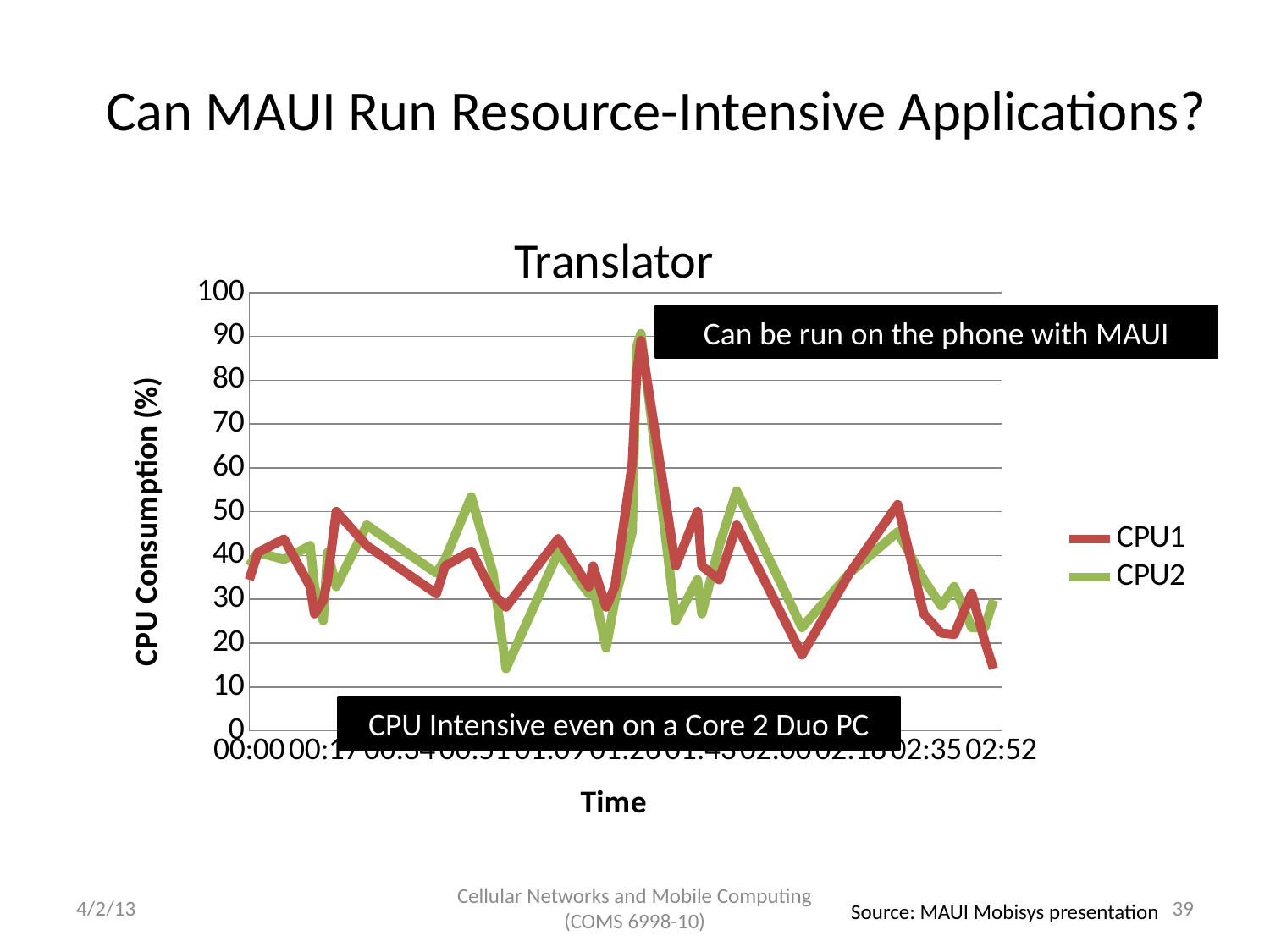
What is the title of the chart? Translator What is the label of the y axis of the Translator chart? CPU Consumption (%) Is the peak value of CPU1 in the Translator chart greater or less than 80? greater Is the value of CPU1 at 00:00 in the Translator chart greater or less than 50? less Is the lowest value of CPU2 in the Translator chart greater or less than 20? less How many series does the legend of the Translator chart list? 2 What is the highest value shown on the y axis of the Translator chart? 100 What kind of chart is shown on the slide? line chart